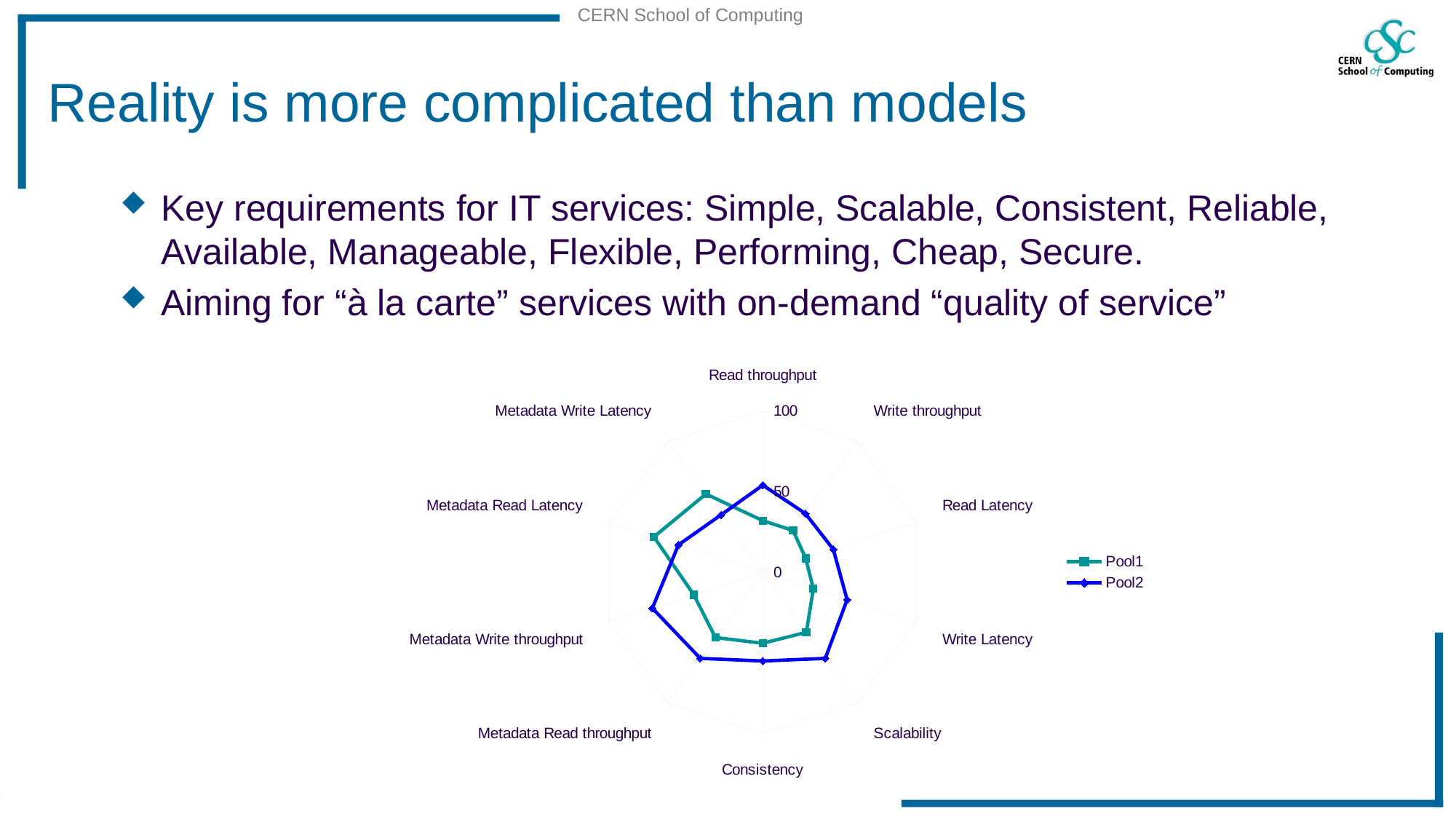
What kind of chart is shown on the slide? Radar chart Which series has the larger value for Metadata Read Latency, Pool1 or Pool2? Pool1 How many series does the chart legend list? 2 For Pool2, which category has the highest value? Metadata Write throughput Is the Pool1 value for Read throughput greater or less than 50? less Is the Pool2 value for Metadata Write throughput greater or less than 50? greater Which series has the larger value for Write Latency, Pool1 or Pool2? Pool2 How many categories (axes) does the radar chart have? 10 Is the Pool1 value for Write Latency greater or less than 50? less What is the maximum value shown on the radial axis of the chart? 100 What are the names of the two series in the legend? Pool1 and Pool2